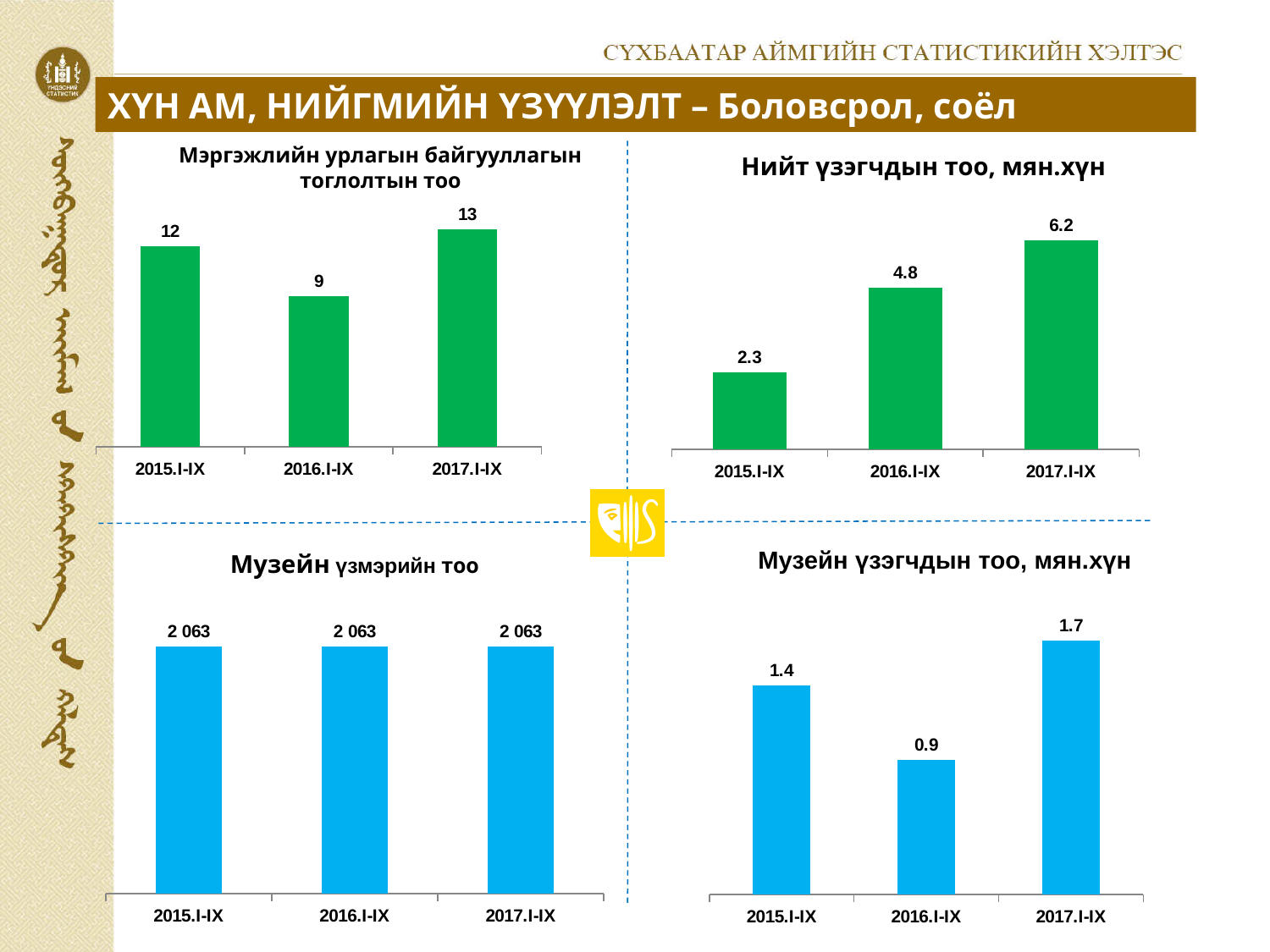
How many periods are shown in the bottom-left chart 'Музейн үзмэрийн тоо'? 3 In the top-left chart 'Мэргэжлийн урлагын байгууллагын тоглолтын тоо', what is the value for 2016.I-IX? 9 In the top-left chart 'Мэргэжлийн урлагын байгууллагын тоглолтын тоо', which period has the highest value? 2017.I-IX What type of chart is the top-right chart 'Нийт үзэгчдын тоо, мян.хүн'? bar chart In the top-left chart 'Мэргэжлийн урлагын байгууллагын тоглолтын тоо', what is the difference between the 2017.I-IX and 2015.I-IX values? 1 In the top-right chart 'Нийт үзэгчдын тоо, мян.хүн', do the values rise or fall from 2015.I-IX to 2017.I-IX? rise In the top-right chart 'Нийт үзэгчдын тоо, мян.хүн', what is the value for 2015.I-IX? 2.3 In the bottom-left chart 'Музейн үзмэрийн тоо', what is the value for 2017.I-IX? 2 063 In the bottom-right chart 'Музейн үзэгчдын тоо, мян.хүн', which is larger, the value for 2015.I-IX or 2016.I-IX? 2015.I-IX In the bottom-right chart 'Музейн үзэгчдын тоо, мян.хүн', what is the value for 2017.I-IX? 1.7 In the top-right chart 'Нийт үзэгчдын тоо, мян.хүн', what is the difference between the 2017.I-IX and 2016.I-IX values? 1.4 In the bottom-right chart 'Музейн үзэгчдын тоо, мян.хүн', which period has the lowest value? 2016.I-IX